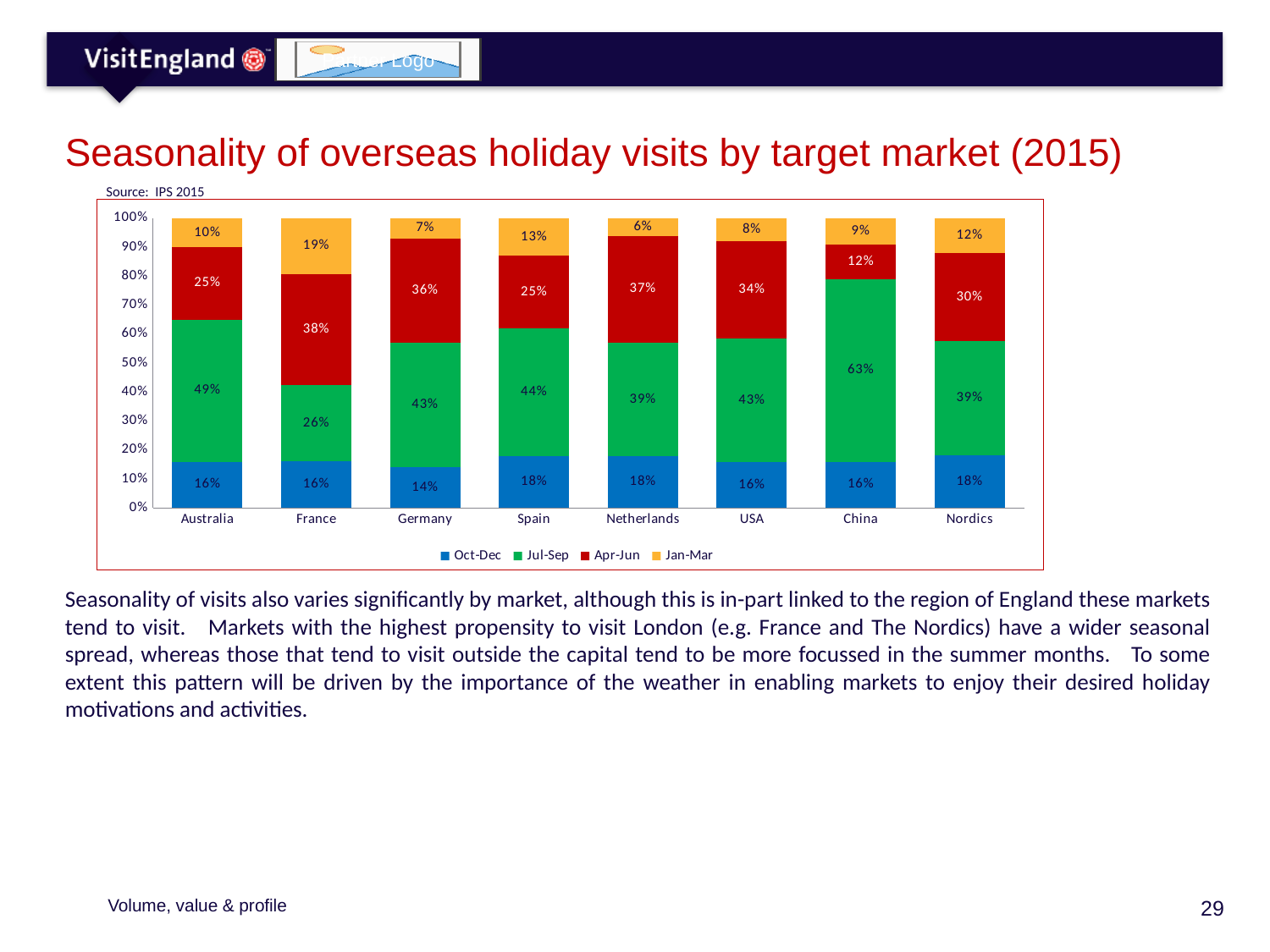
What is the difference between the Apr-Jun shares for France and China? 26% Which market has the lowest Jan-Mar share? Netherlands What kind of chart is shown on the slide? Stacked bar chart How many markets are shown on the x axis? 8 Is the Apr-Jun share larger for Germany or for Spain? Germany How many series does the legend list? 4 Which market has the lowest Jul-Sep share? France What is the Oct-Dec share for Germany? 14% What is the Jul-Sep share for China? 63% What is the Apr-Jun share for the Netherlands? 37% What is the Jan-Mar share for France? 19% Which market has the highest Jul-Sep share? China